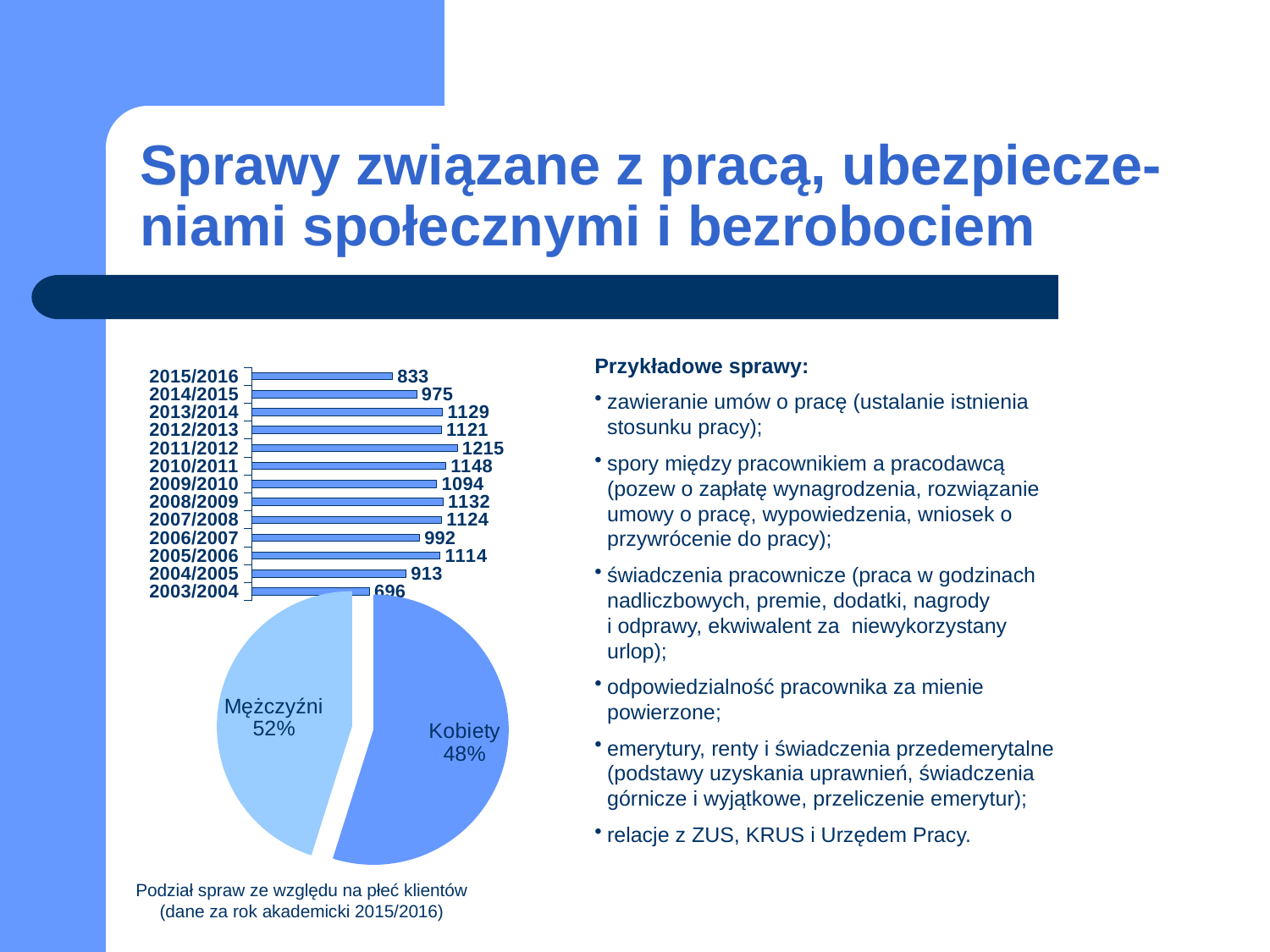
What is the caption below the pie chart? Podział spraw ze względu na płeć klientów (dane za rok akademicki 2015/2016) In the bar chart, which is larger: the value for 2014/2015 or the value for 2006/2007? 2006/2007 How many academic years are shown in the bar chart? 13 In the pie chart, what share is labelled Mężczyźni? 52% In the bar chart, what is the value for 2003/2004? 696 In the bar chart, what is the difference between the values for 2011/2012 and 2015/2016? 382 What kind of chart shows the values by academic year? bar chart In the bar chart, which academic year has the highest value? 2011/2012 In the bar chart, what is the value for 2011/2012? 1215 In the bar chart, which academic year has the lowest value? 2003/2004 In the pie chart, what share is labelled Kobiety? 48% In the bar chart, what is the value for 2015/2016? 833